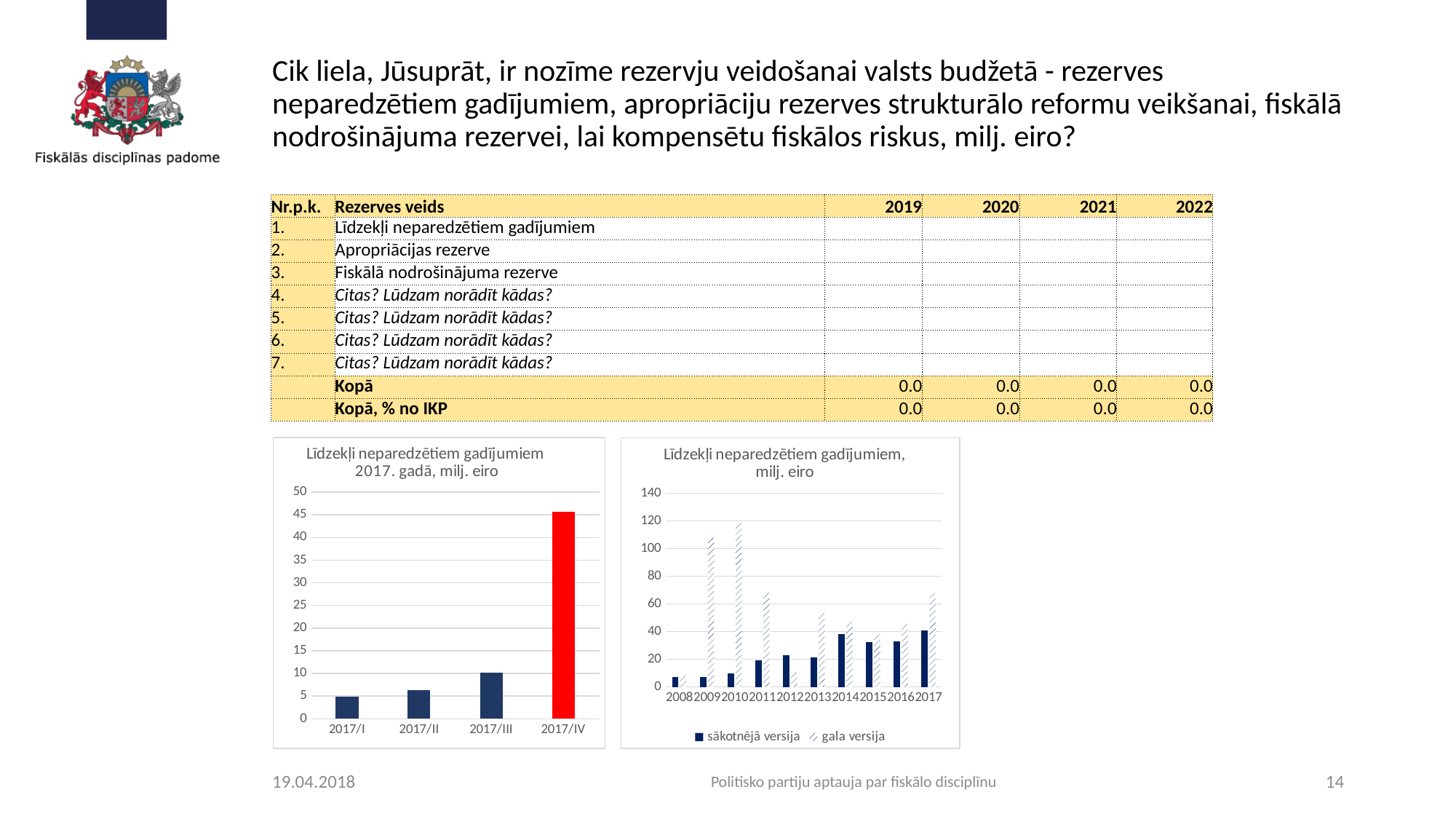
In the left chart titled 'Līdzekļi neparedzētiem gadījumiem 2017. gadā, milj. eiro', is the value for 2017/IV greater or less than 40? greater In the left chart titled 'Līdzekļi neparedzētiem gadījumiem 2017. gadā, milj. eiro', do the values rise or fall from 2017/I to 2017/IV? Rise In the left chart titled 'Līdzekļi neparedzētiem gadījumiem 2017. gadā, milj. eiro', which quarter has the highest value? 2017/IV In the right chart titled 'Līdzekļi neparedzētiem gadījumiem, milj. eiro', which year has the highest 'gala versija' value? 2010 In the left chart titled 'Līdzekļi neparedzētiem gadījumiem 2017. gadā, milj. eiro', which quarter has the lowest value? 2017/I In the left chart titled 'Līdzekļi neparedzētiem gadījumiem 2017. gadā, milj. eiro', is the value for 2017/II greater or less than 10? less In the left chart titled 'Līdzekļi neparedzētiem gadījumiem 2017. gadā, milj. eiro', which bar is coloured red? 2017/IV What kind of chart is the left chart titled 'Līdzekļi neparedzētiem gadījumiem 2017. gadā, milj. eiro'? Bar chart In the right chart titled 'Līdzekļi neparedzētiem gadījumiem, milj. eiro', is the 'gala versija' value for 2009 greater or less than 100? greater How many series does the legend list in the right chart titled 'Līdzekļi neparedzētiem gadījumiem, milj. eiro'? 2 How many categories are shown on the x axis of the left chart titled 'Līdzekļi neparedzētiem gadījumiem 2017. gadā, milj. eiro'? 4 How many years are shown on the x axis of the right chart titled 'Līdzekļi neparedzētiem gadījumiem, milj. eiro'? 10